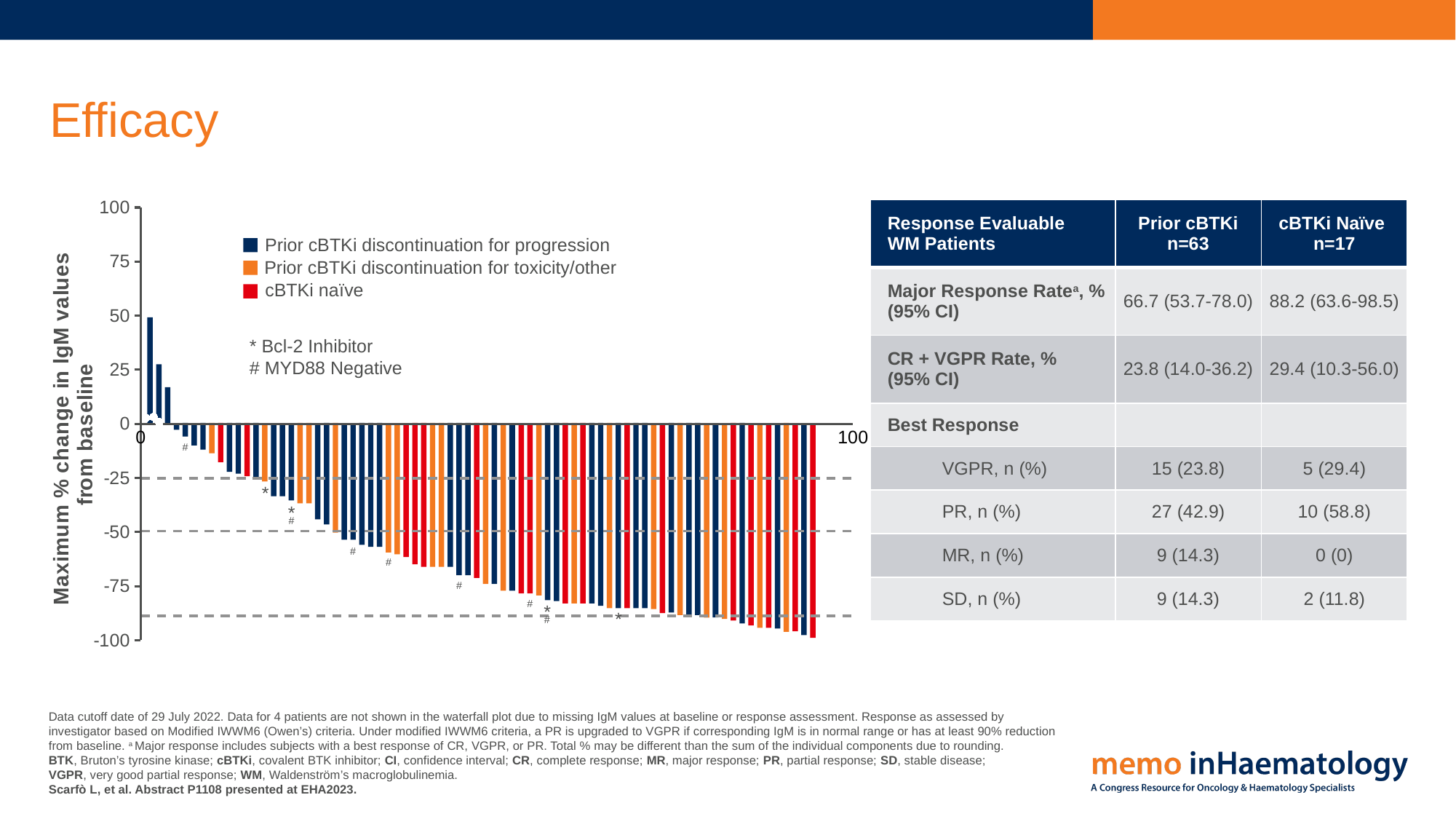
How many series does the legend of the waterfall chart list? 3 Is the value of the leftmost bar in the waterfall chart greater or less than 25? greater What kind of chart is shown on the left of the slide? Bar chart Do the bar values in the waterfall chart rise or fall from left to right? Fall Which is larger in the waterfall chart, the leftmost bar or the second bar from the left? The leftmost bar What is the label of the y axis of the waterfall chart? Maximum % change in IgM values from baseline Which legend series does the highest bar in the waterfall chart belong to? Prior cBTKi discontinuation for progression How many bars in the waterfall chart are above 0? 3 Is the value of the rightmost bar in the waterfall chart greater or less than -75? less What are the three legend entries of the waterfall chart? Prior cBTKi discontinuation for progression; Prior cBTKi discontinuation for toxicity/other; cBTKi naïve